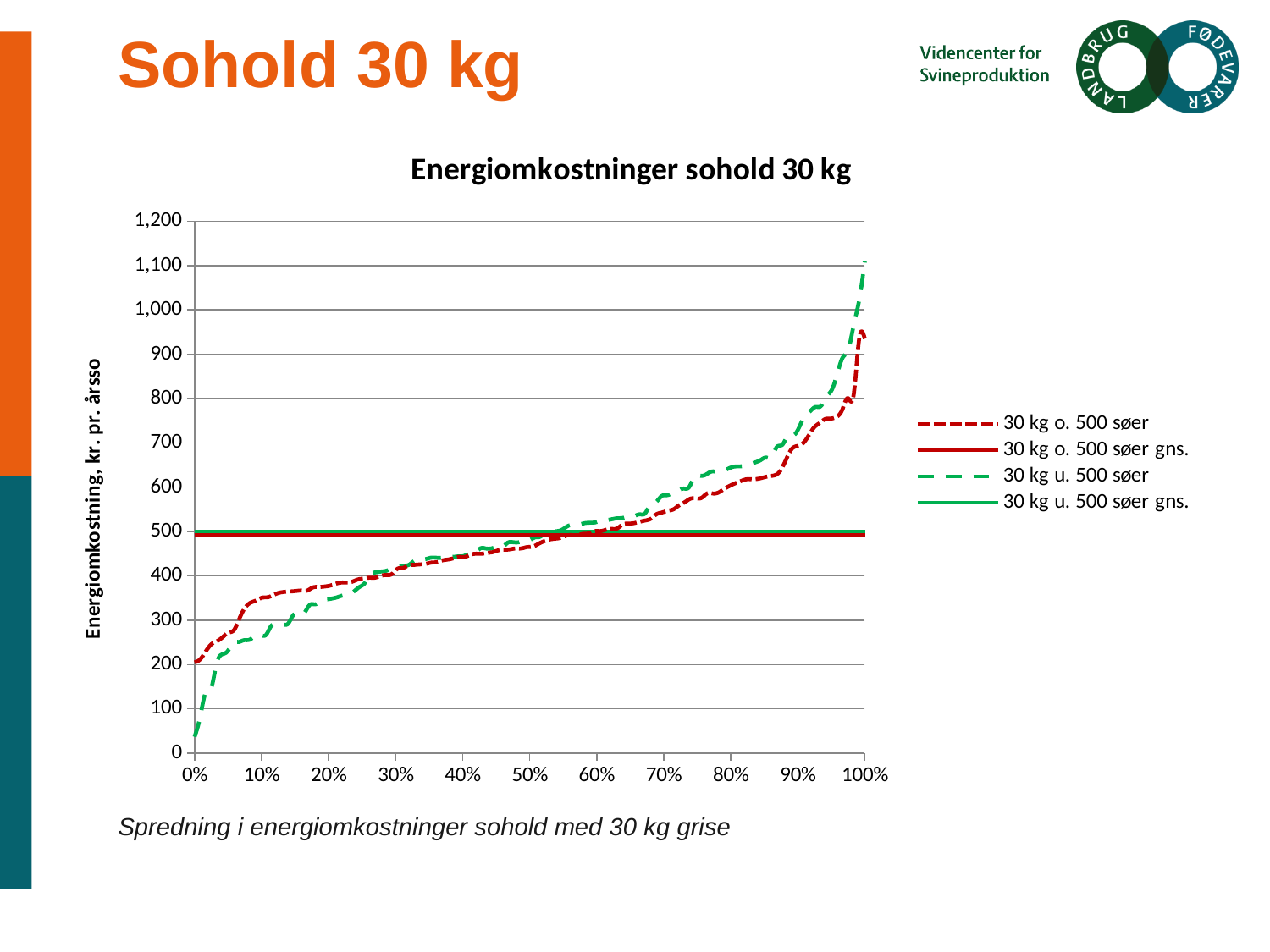
What is the title of the chart? Energiomkostninger sohold 30 kg Do the values of the '30 kg u. 500 søer' series rise or fall along the x axis? rise Do the values of the '30 kg o. 500 søer' series rise or fall along the x axis? rise Is the value for '30 kg u. 500 søer' at 100% greater or less than 1,000? greater What is the label on the vertical axis of the chart? Energiomkostning, kr. pr. årsso Is the value for '30 kg o. 500 søer' at 10% greater or less than 300? greater Is the value for '30 kg u. 500 søer' at 0% greater or less than 100? less At 0%, which series has the higher value: '30 kg o. 500 søer' or '30 kg u. 500 søer'? 30 kg o. 500 søer How many series does the legend list? 4 What kind of chart is shown on the slide? line chart At 100%, which series has the higher value: '30 kg o. 500 søer' or '30 kg u. 500 søer'? 30 kg u. 500 søer